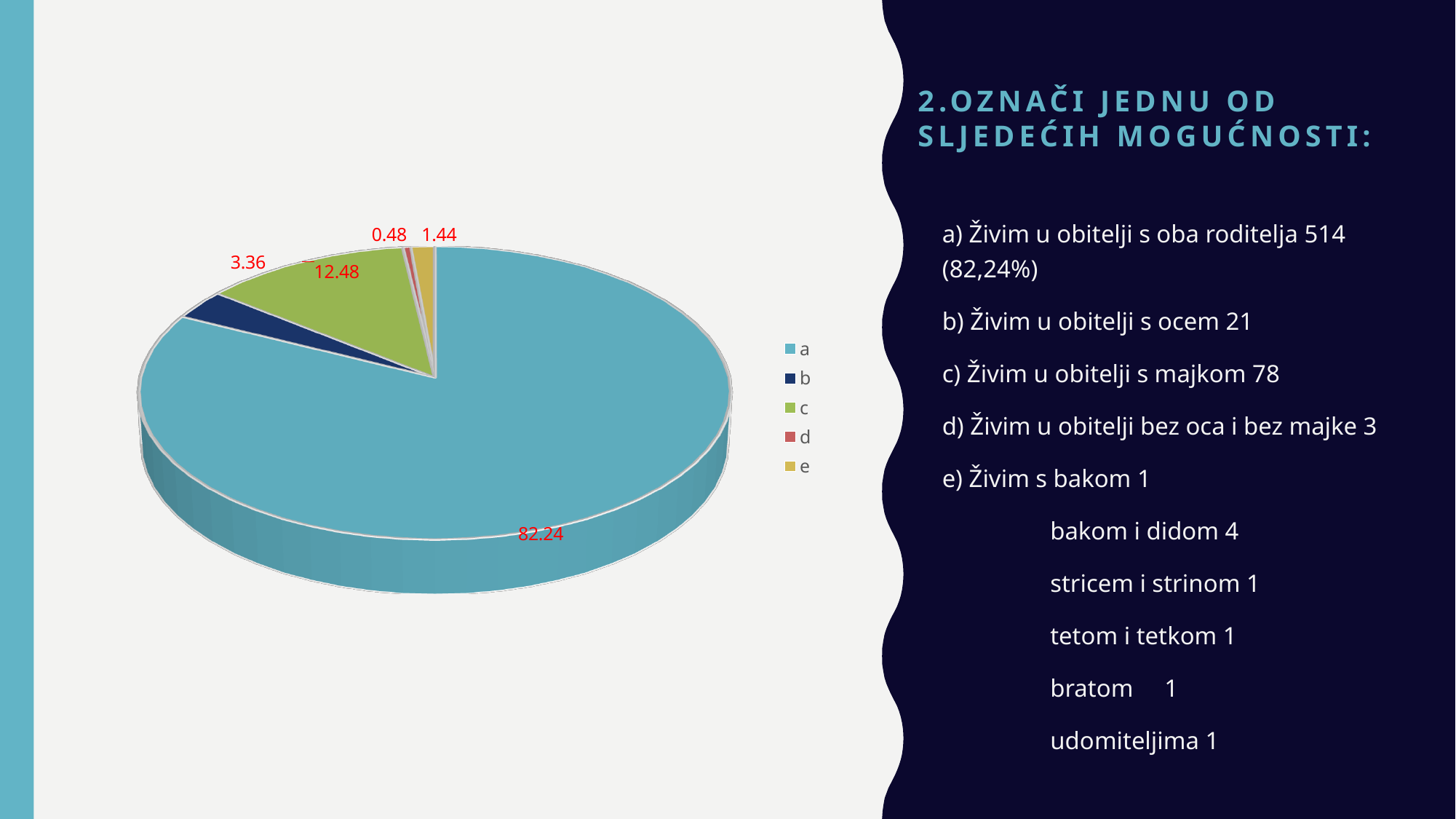
Which is larger, the value for slice e or the value for slice d? e How many slices does the pie chart have? 5 How many entries does the legend of the pie chart list? 5 Which slice of the pie chart is the smallest? d What is the value shown for slice c in the pie chart? 12.48 Which slice of the pie chart is the largest? a What is the value shown for slice d in the pie chart? 0.48 What kind of chart is shown on the slide? pie chart What is the value shown for slice e in the pie chart? 1.44 What is the value shown for slice b in the pie chart? 3.36 What is the difference between the values for slice c and slice b? 9.12 What is the value shown for slice a in the pie chart? 82.24